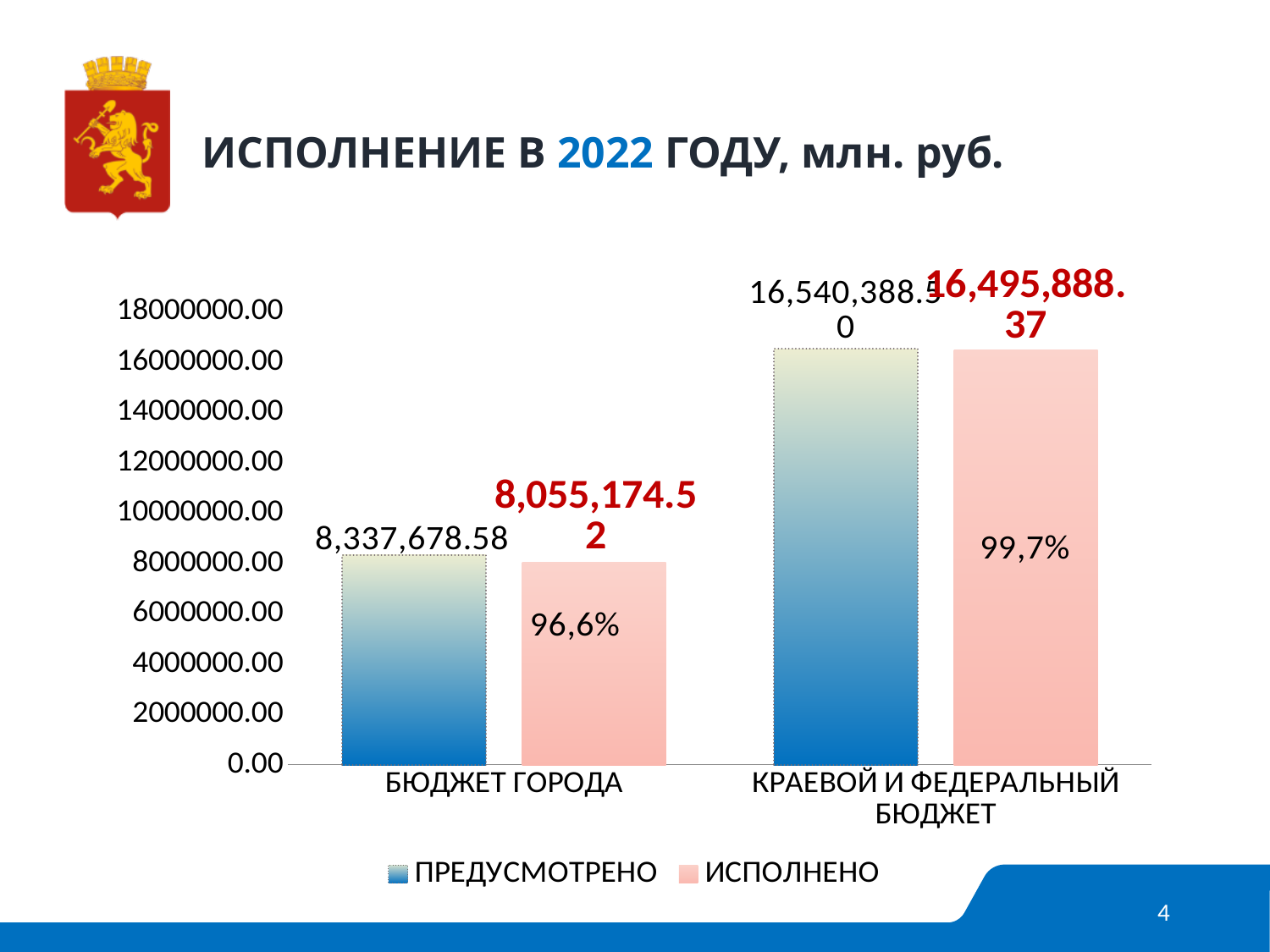
How many series does the legend list? 2 What is the difference between the ПРЕДУСМОТРЕНО and ИСПОЛНЕНО values for БЮДЖЕТ ГОРОДА? 282,504.06 Is the ПРЕДУСМОТРЕНО value for КРАЕВОЙ И ФЕДЕРАЛЬНЫЙ БЮДЖЕТ greater or less than 16000000.00? greater How many categories are shown on the x axis? 2 What is the ИСПОЛНЕНО value for БЮДЖЕТ ГОРОДА? 8,055,174.52 Which category has the higher ИСПОЛНЕНО value, БЮДЖЕТ ГОРОДА or КРАЕВОЙ И ФЕДЕРАЛЬНЫЙ БЮДЖЕТ? КРАЕВОЙ И ФЕДЕРАЛЬНЫЙ БЮДЖЕТ What is the title of the slide containing the chart? ИСПОЛНЕНИЕ В 2022 ГОДУ, млн. руб. What type of chart is shown on the slide? bar chart What percentage is printed on the ИСПОЛНЕНО bar for КРАЕВОЙ И ФЕДЕРАЛЬНЫЙ БЮДЖЕТ? 99,7% What is the ПРЕДУСМОТРЕНО value for БЮДЖЕТ ГОРОДА? 8,337,678.58 What percentage is printed on the ИСПОЛНЕНО bar for БЮДЖЕТ ГОРОДА? 96,6% What is the ИСПОЛНЕНО value for КРАЕВОЙ И ФЕДЕРАЛЬНЫЙ БЮДЖЕТ? 16,495,888.37